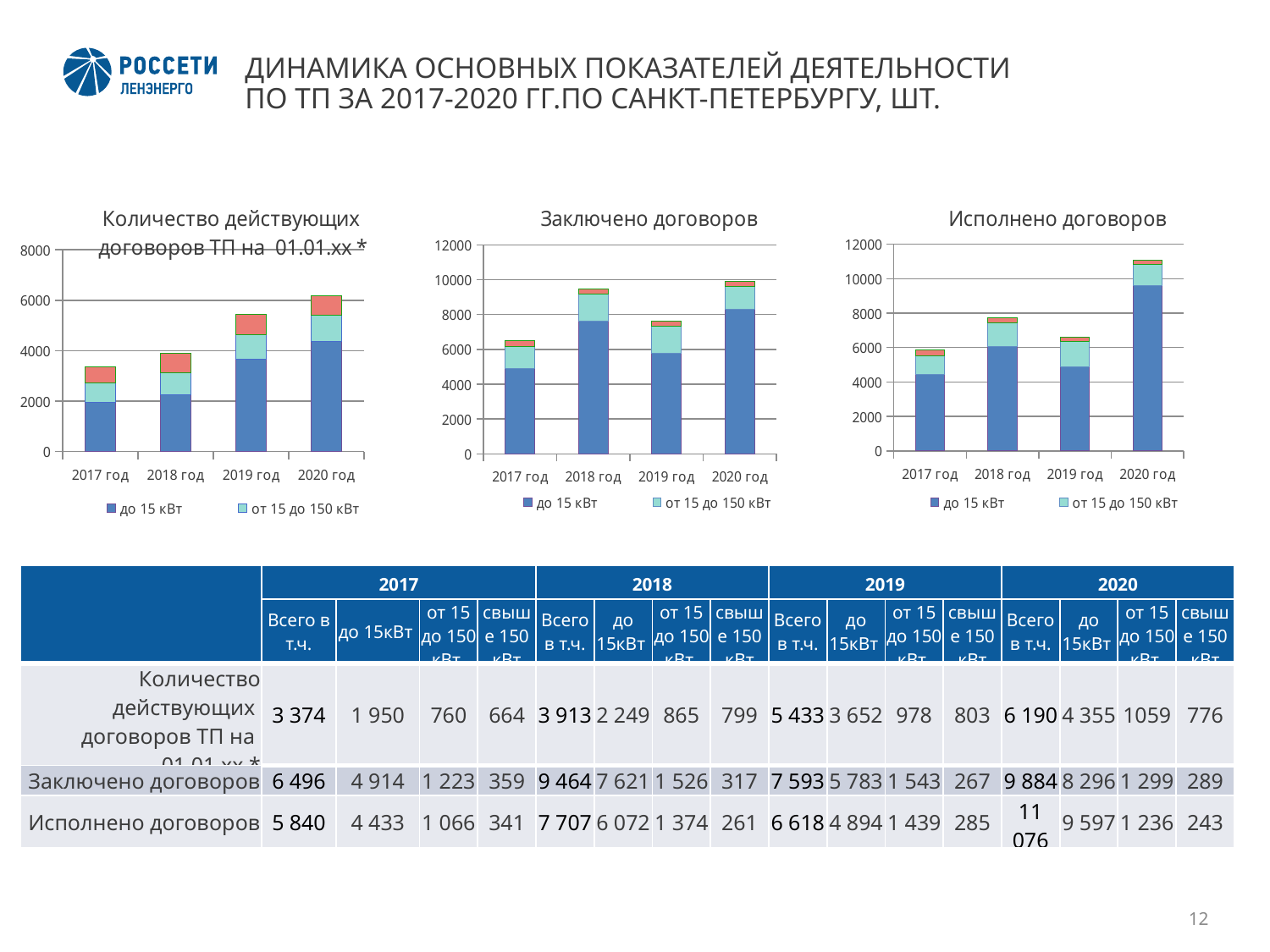
Do the total bar heights in the 'Количество действующих договоров ТП' chart rise or fall from 2017 год to 2020 год? rise How many series does the legend of the 'Количество действующих договоров ТП' chart list? 2 In the 'Количество действующих договоров ТП' chart, which year has the tallest bar? 2020 год In the 'Заключено договоров' chart, which year has the shortest bar? 2017 год In the 'Исполнено договоров' chart, is the total bar for 2019 год greater or less than 8000? less In the 'Исполнено договоров' chart, which year has the tallest bar? 2020 год In the 'Заключено договоров' chart, is the total bar for 2017 год greater or less than 6000? greater In the 'Заключено договоров' chart, which bar is taller: 2018 год or 2019 год? 2018 год What kind of chart is the 'Заключено договоров' chart? stacked bar chart In the 'Исполнено договоров' chart, is the total bar for 2020 год greater or less than 10000? greater How many year categories are shown on the x axis of the 'Исполнено договоров' chart? 4 Which legend entry is shown in dark blue in the 'Исполнено договоров' chart? до 15 кВт